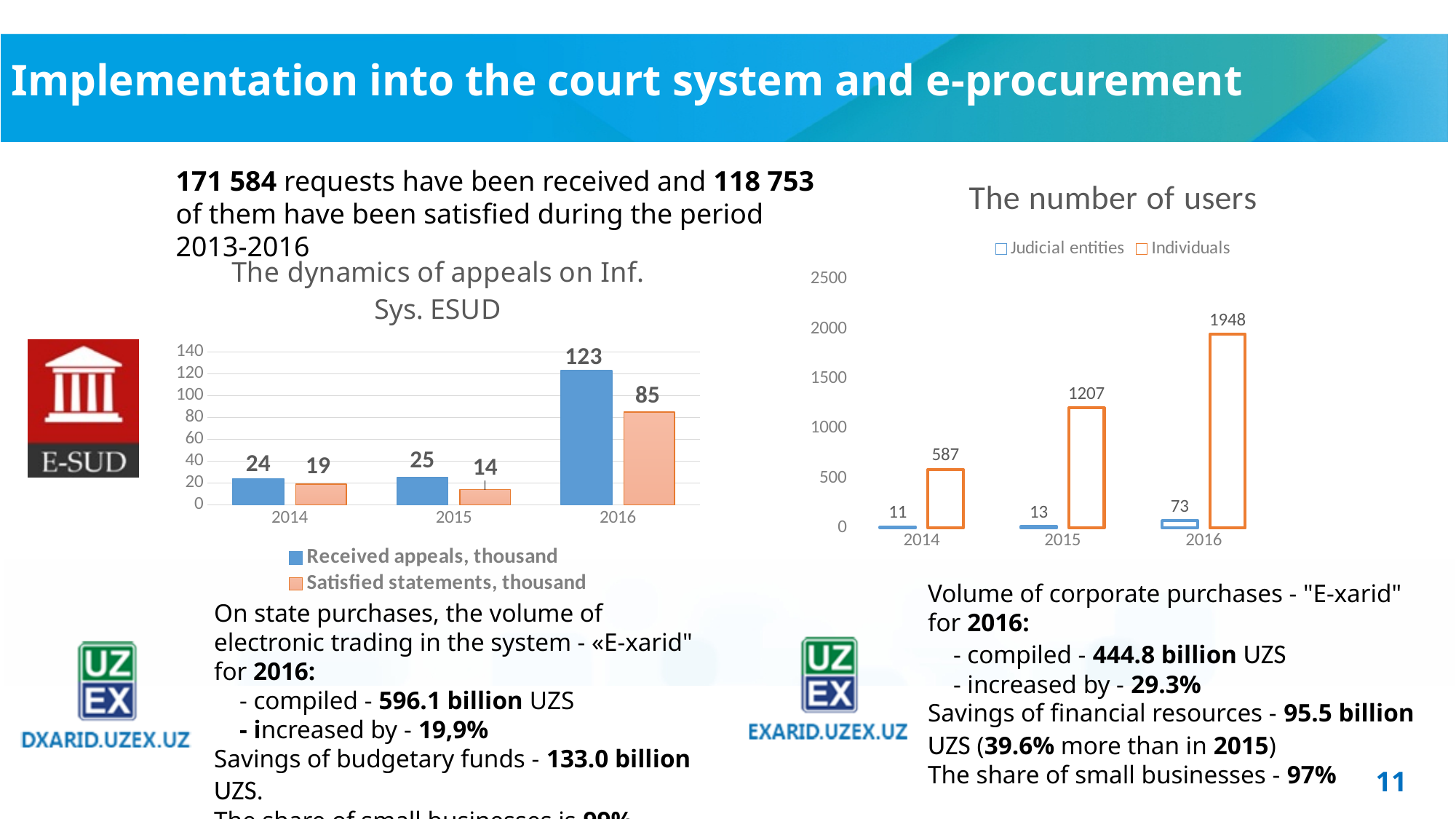
In the chart 'The number of users', what is the value for Judicial entities in 2016? 73 In the chart 'The number of users', which year has the lowest value for Individuals? 2014 In the chart 'The number of users', what is the difference between Individuals in 2016 and 2015? 741 In the chart 'The dynamics of appeals on Inf. Sys. ESUD', how many series does the legend list? 2 In the chart 'The dynamics of appeals on Inf. Sys. ESUD', which year has the highest value for Received appeals, thousand? 2016 In the chart 'The dynamics of appeals on Inf. Sys. ESUD', do the Received appeals values rise or fall from 2014 to 2016? rise In the chart 'The number of users', what is the value for Individuals in 2015? 1207 In the chart 'The dynamics of appeals on Inf. Sys. ESUD', what is the value of Received appeals, thousand for 2016? 123 In the chart 'The number of users', how many years are shown on the x axis? 3 What kind of chart is 'The number of users'? bar chart In the chart 'The dynamics of appeals on Inf. Sys. ESUD', what is the value of Satisfied statements, thousand for 2015? 14 In the chart 'The dynamics of appeals on Inf. Sys. ESUD', what is the difference between Received appeals and Satisfied statements in 2016? 38